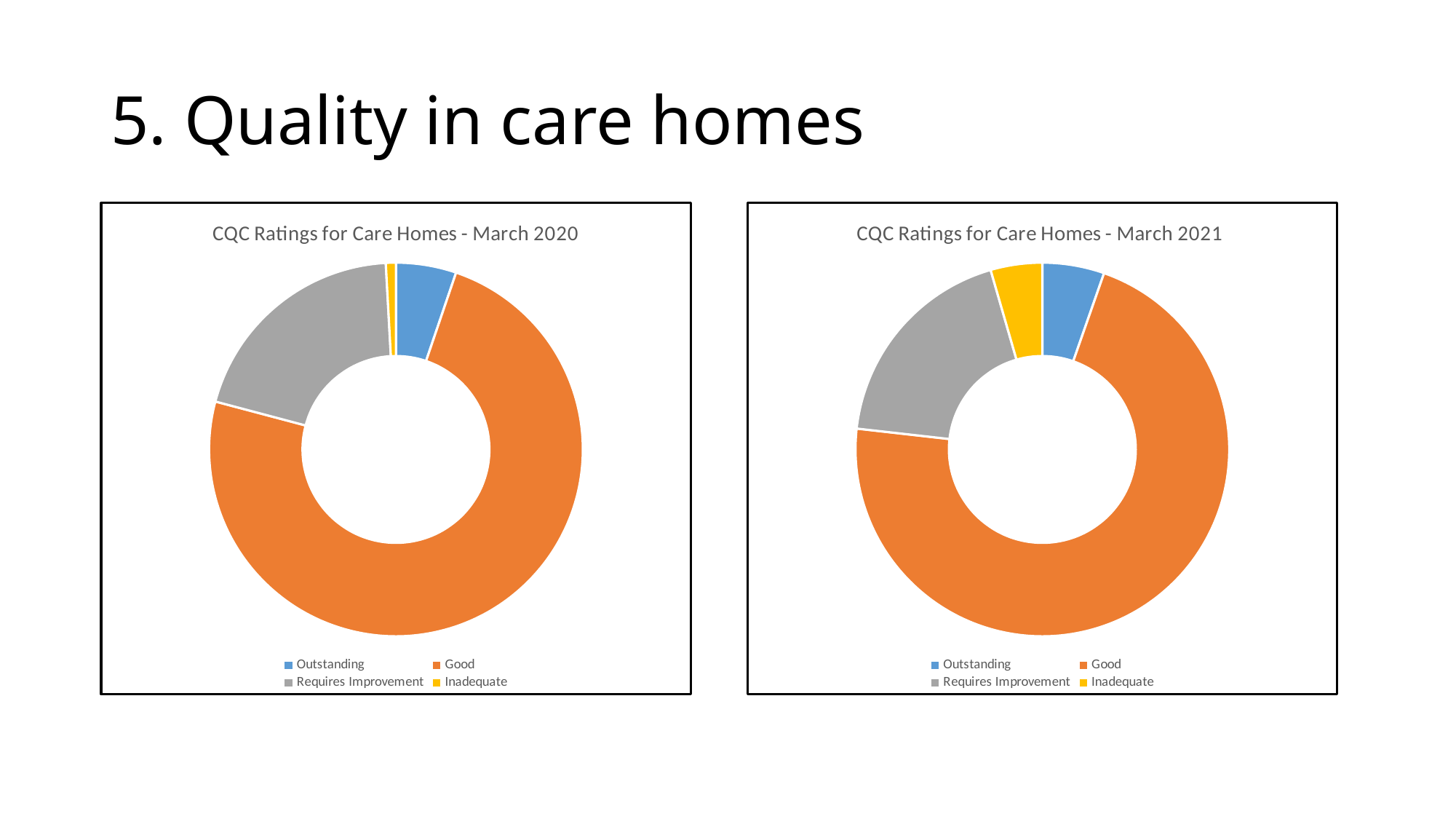
In the 'CQC Ratings for Care Homes - March 2021' chart, which is larger: Requires Improvement or Inadequate? Requires Improvement How many rating categories does the legend of the 'CQC Ratings for Care Homes - March 2021' chart list? 4 What colour represents the Good category in the 'CQC Ratings for Care Homes - March 2020' chart? Orange In the 'CQC Ratings for Care Homes - March 2020' chart, which rating category has the largest share? Good What is the title of the chart on the right of the slide? CQC Ratings for Care Homes - March 2021 What kind of chart is the 'CQC Ratings for Care Homes - March 2020' chart? doughnut chart In the 'CQC Ratings for Care Homes - March 2021' chart, which is larger: Good or Requires Improvement? Good In the 'CQC Ratings for Care Homes - March 2020' chart, which rating category has the smallest share? Inadequate In the 'CQC Ratings for Care Homes - March 2020' chart, which is larger: Requires Improvement or Outstanding? Requires Improvement How many charts are shown on the slide? 2 In the 'CQC Ratings for Care Homes - March 2021' chart, which rating category has the largest share? Good